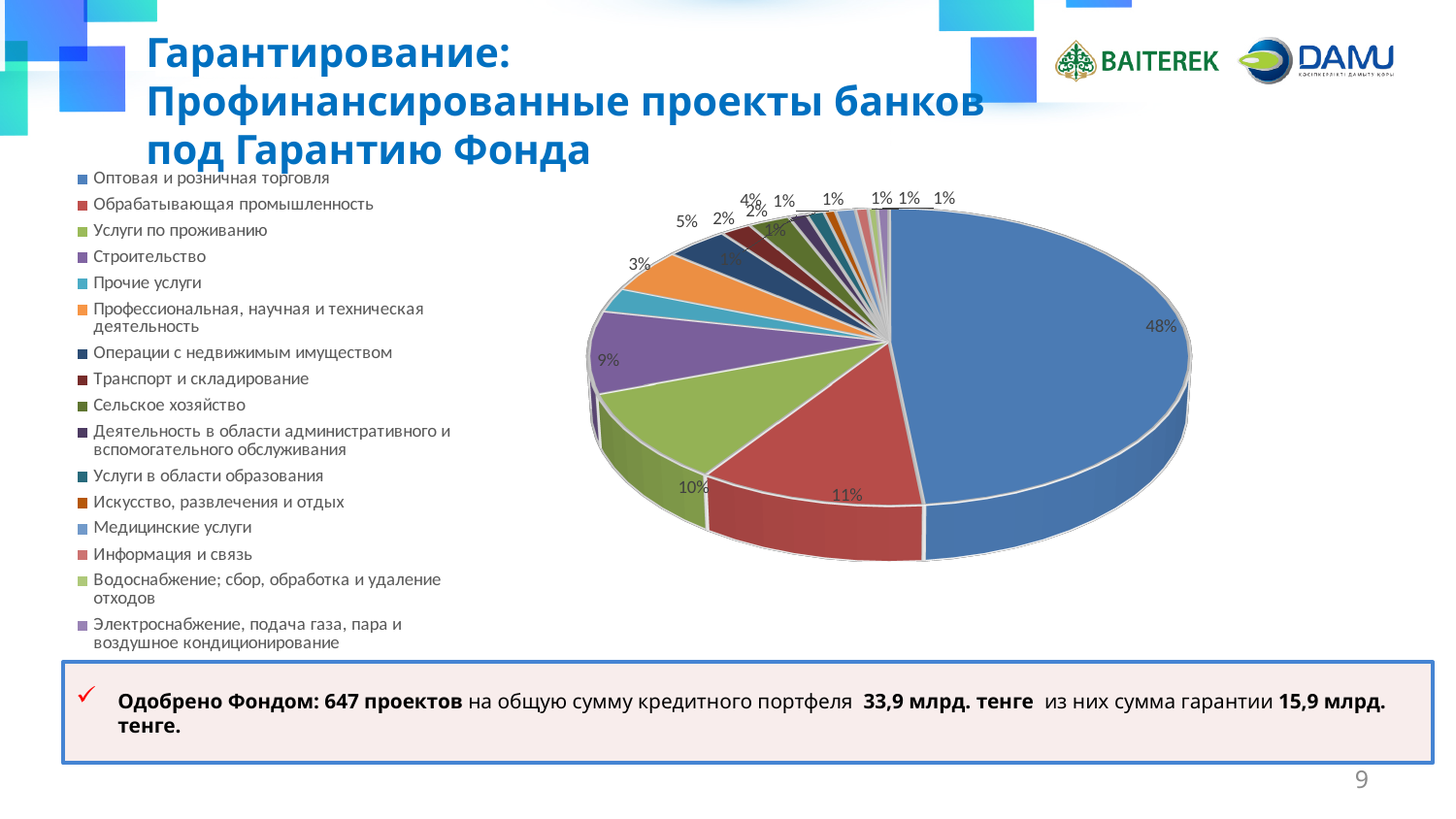
What is the difference in percentage points between Оптовая и розничная торговля and Обрабатывающая промышленность? 37 percentage points What is the value shown for Услуги по проживанию? 10% What share of the pie does Оптовая и розничная торговля have? 48% How many categories does the legend list? 16 Which is larger: the share for Услуги по проживанию or the share for Строительство? Услуги по проживанию What colour is the slice for Обрабатывающая промышленность? red What is the value shown for Прочие услуги? 3% What kind of chart is shown on the slide? pie chart What is the value shown for Профессиональная, научная и техническая деятельность? 5% What is the value shown for Строительство? 9% Which category has the largest share of the pie? Оптовая и розничная торговля What is the value shown for Обрабатывающая промышленность? 11%